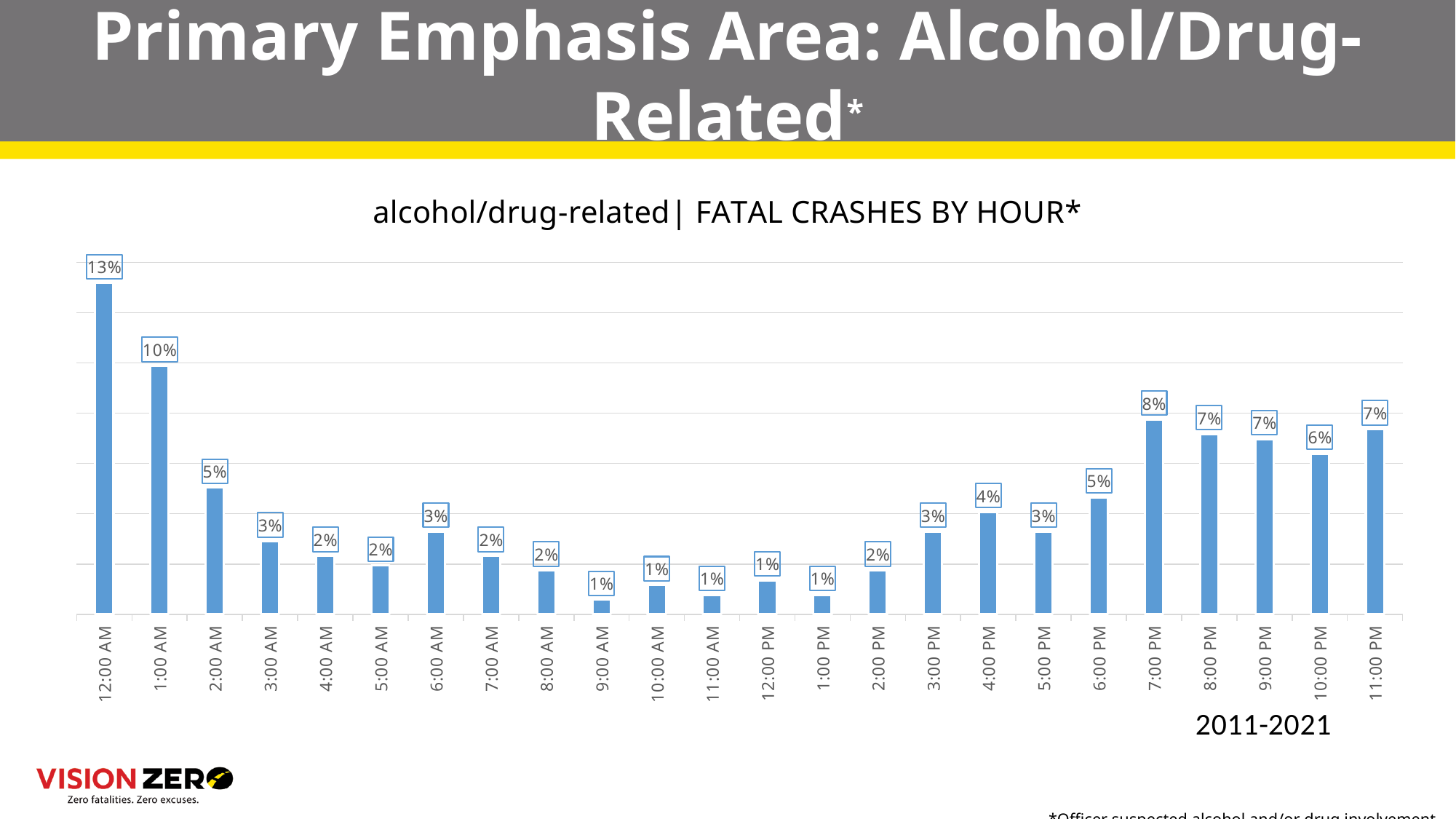
What kind of chart is shown on the slide? Bar chart Which hour has the highest share of alcohol/drug-related fatal crashes? 12:00 AM What is the value for 4:00 PM? 4% What percentage of alcohol/drug-related fatal crashes occurred at 12:00 AM? 13% Which is larger, the value for 2:00 AM or the value for 6:00 PM? They are equal (5%) What is the difference between the values for 12:00 AM and 1:00 AM? 3% What is the difference between the values for 7:00 PM and 10:00 PM? 2% Which is larger, the value for 1:00 AM or the value for 7:00 PM? 1:00 AM What percentage is shown for 1:00 AM? 10% How many hourly categories are plotted on the chart? 24 What time period does the chart cover, as noted below the x axis? 2011-2021 What is the value shown for 7:00 PM? 8%